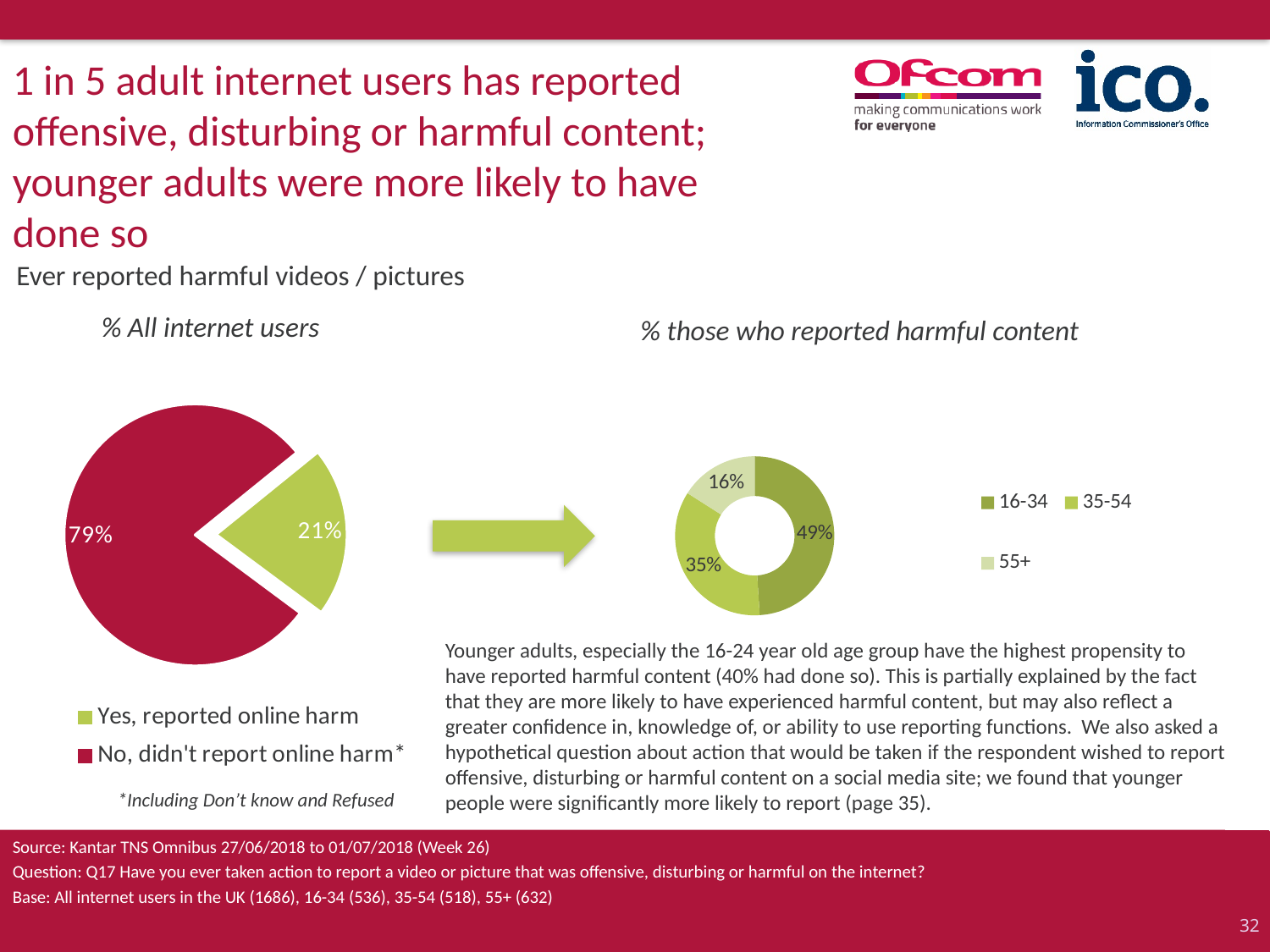
In the '% All internet users' pie chart, which category has the larger share? No, didn't report online harm* In the '% those who reported harmful content' chart, what share is the 55+ age group? 16% In the '% those who reported harmful content' chart, what share is the 16-34 age group? 49% In the '% those who reported harmful content' chart, how many percentage points larger is the 16-34 share than the 35-54 share? 14 percentage points In the '% All internet users' pie chart, what is the difference between the 'No' and 'Yes' shares? 58% In the '% those who reported harmful content' chart, what share is the 35-54 age group? 35% In the '% those who reported harmful content' chart, which age group has the largest share? 16-34 How many age groups are shown in the '% those who reported harmful content' chart? 3 In the '% those who reported harmful content' chart, which age group has the smallest share? 55+ In the '% All internet users' pie chart, what percentage of internet users said yes, they reported online harm? 21% In the '% All internet users' pie chart, what percentage of internet users did not report online harm? 79% What type of chart is the '% All internet users' chart? Pie chart